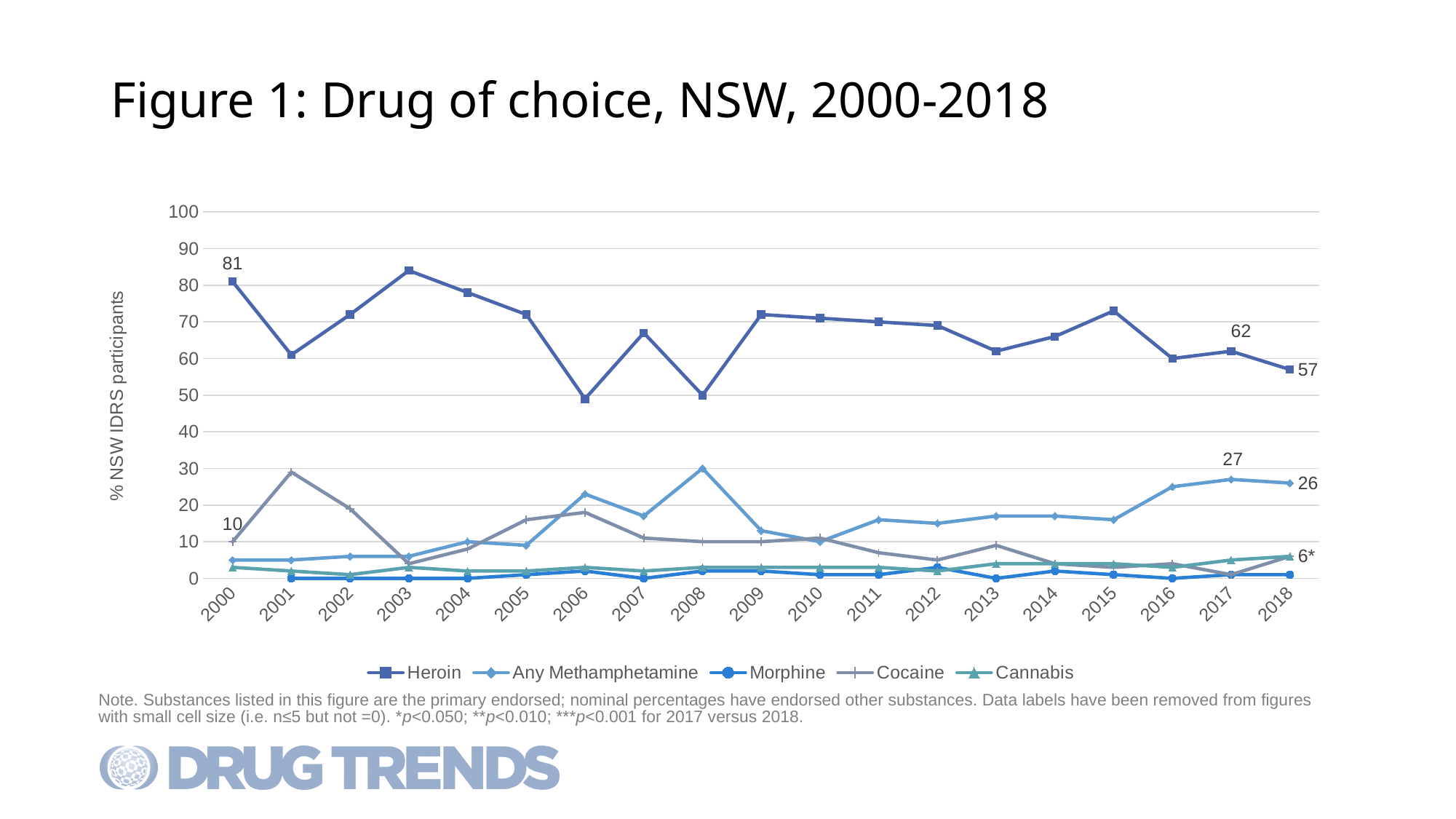
What kind of chart is shown on the slide? line chart What is the value for Any Methamphetamine in 2017? 27 What is the data label shown for Cannabis in 2018? 6* What is the value for Heroin in 2018? 57 What is the value for Heroin in 2000? 81 In 2018, which is larger: the value for Heroin or the value for Any Methamphetamine? Heroin By how much did the Heroin value fall from 2017 to 2018? 5 What is the difference between the Heroin value in 2000 and in 2018? 24 What is the value for Cocaine in 2000? 10 Is the value for Cocaine in 2001 greater or less than 20? greater How many series does the legend list? 5 Is the value for Heroin in 2003 greater or less than 80? greater